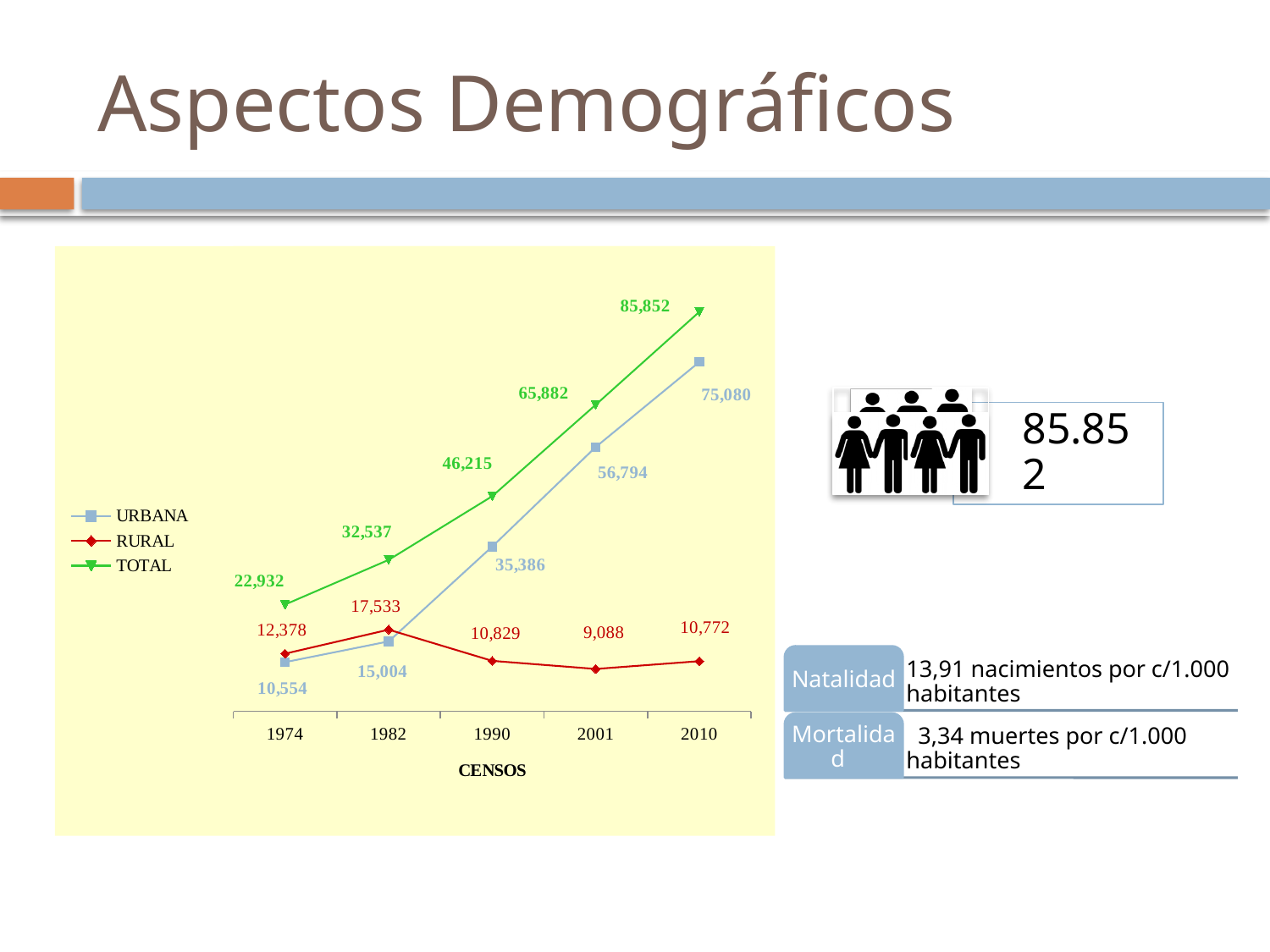
What type of chart is shown on the slide? line chart What is the URBANA value for the 1990 census? 35,386 In which census year is the URBANA series at its lowest? 1974 How many census years are plotted on the x axis? 5 Does the URBANA series rise or fall from 1974 to 2010? rise What is the difference between the TOTAL values for 2010 and 2001? 19,970 What is the RURAL value for the 2001 census? 9,088 In 1974, which series has the larger value, URBANA or RURAL? RURAL What is the title of the x axis of the chart? CENSOS How many series does the chart legend list? 3 What is the TOTAL value for the 2010 census? 85,852 In which census year is the RURAL series at its highest? 1982